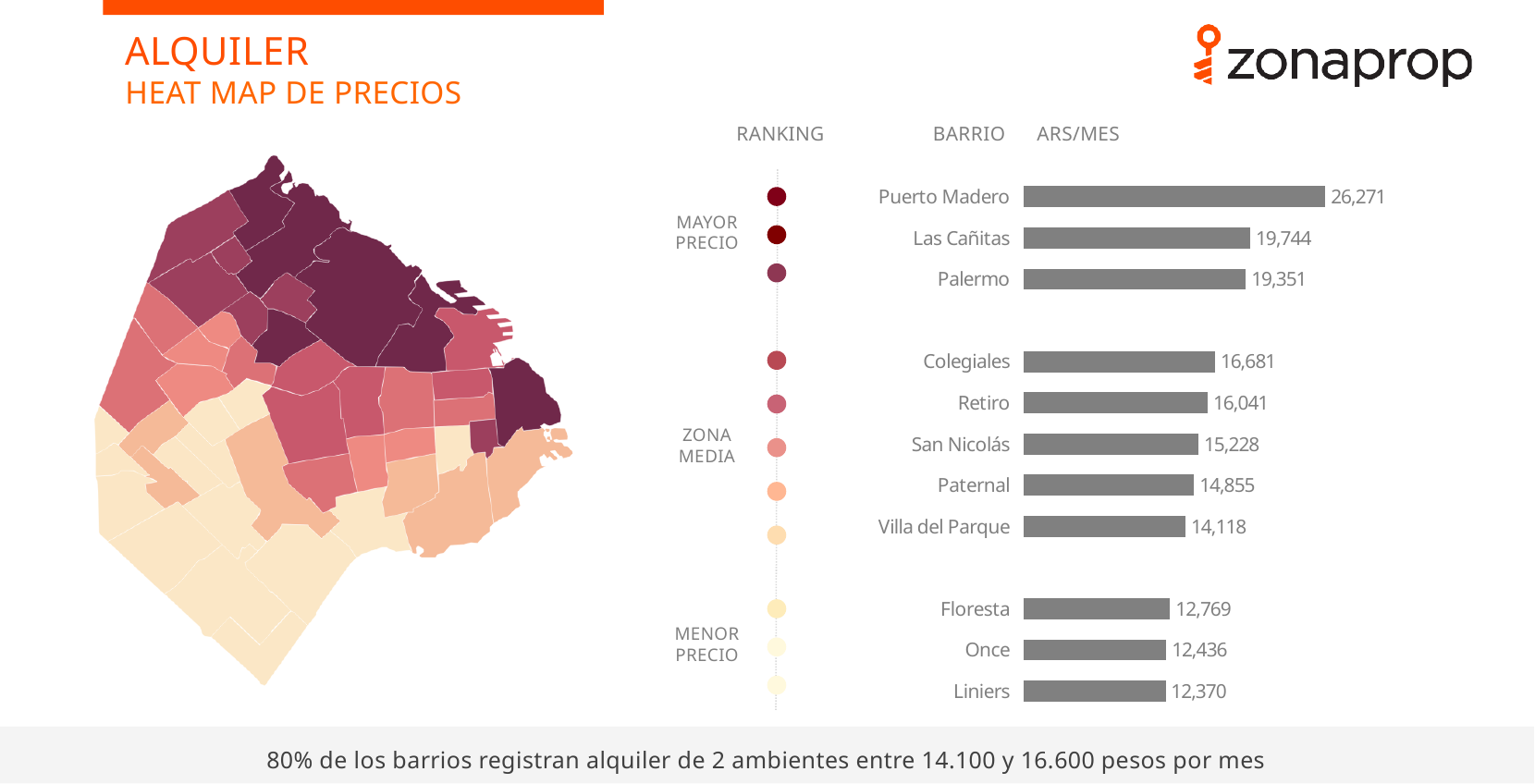
What is the monthly rent value (ARS/MES) shown for Puerto Madero? 26,271 Which has a larger value, Palermo or Colegiales? Palermo What are the three ranking groups labelled next to the bar chart? MAYOR PRECIO, ZONA MEDIA, MENOR PRECIO What is the difference between the values for Colegiales and Retiro? 640 How many barrios are listed in the bar chart? 11 What kind of chart is used to show the ARS/MES values? Bar chart What is the value shown for San Nicolás? 15,228 Do the bar values increase or decrease going from the top barrio to the bottom barrio? Decrease What is the value shown for Villa del Parque? 14,118 Which barrio has the lowest value in the bar chart? Liniers Which barrio has the highest value in the bar chart? Puerto Madero What is the difference between the values for Puerto Madero and Las Cañitas? 6,527